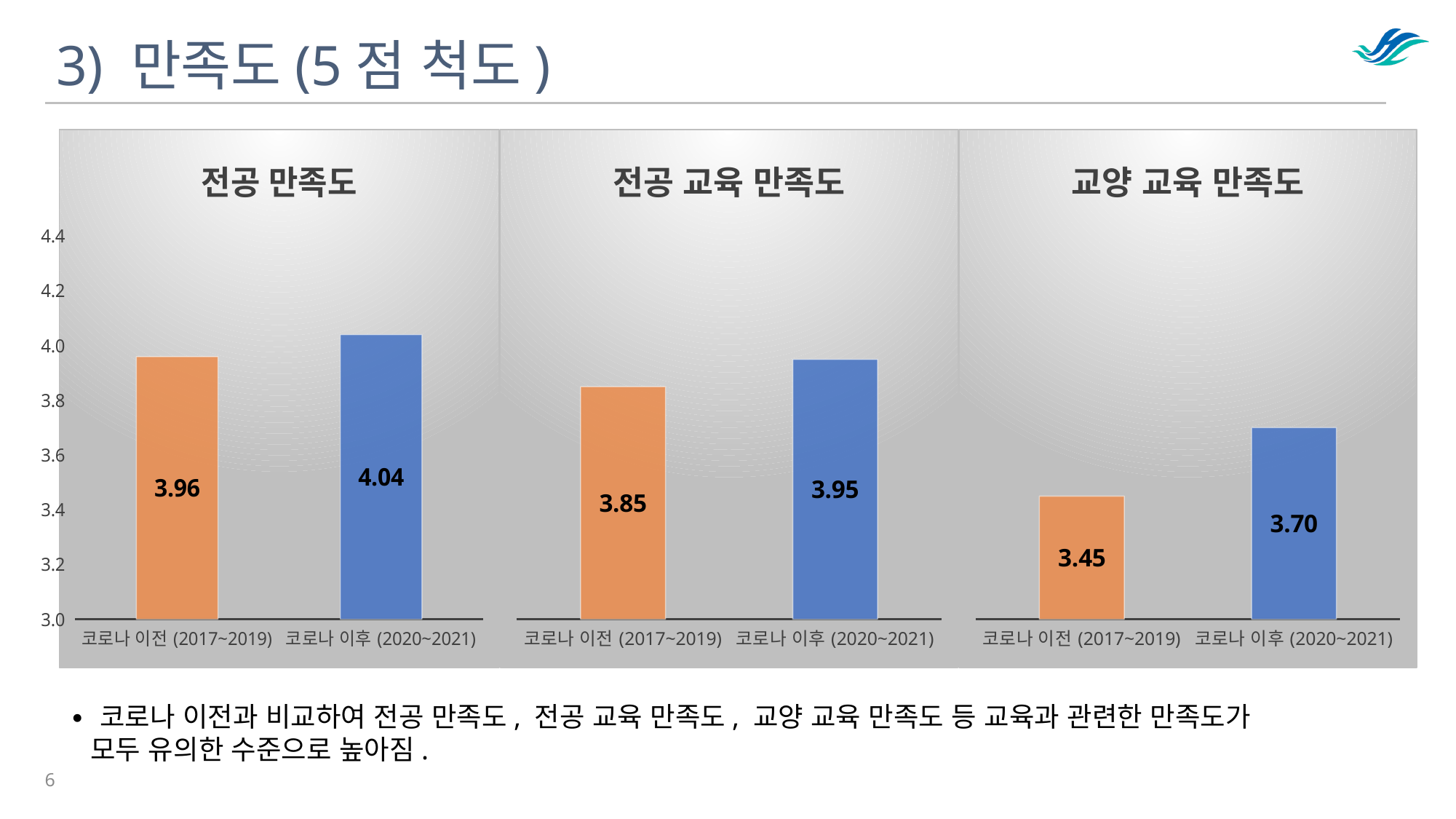
In the 전공 만족도 chart, is the value for 코로나 이후 (2020~2021) greater or less than 4.0? greater In the 전공 교육 만족도 chart, what is the difference between the 코로나 이후 (2020~2021) value and the 코로나 이전 (2017~2019) value? 0.10 In the 전공 만족도 chart, which is larger: the value for 코로나 이전 (2017~2019) or 코로나 이후 (2020~2021)? 코로나 이후 (2020~2021) In the 교양 교육 만족도 chart, which category has the lowest value? 코로나 이전 (2017~2019) In the 전공 교육 만족도 chart, which category has the highest value? 코로나 이후 (2020~2021) In the 교양 교육 만족도 chart, what is the difference between the 코로나 이후 (2020~2021) value and the 코로나 이전 (2017~2019) value? 0.25 How many bars are shown in the 교양 교육 만족도 chart? 2 What kind of chart is the 전공 교육 만족도 chart? bar chart In the 교양 교육 만족도 chart, what is the value for 코로나 이후 (2020~2021)? 3.70 In the 전공 교육 만족도 chart, what is the value for 코로나 이전 (2017~2019)? 3.85 In the 전공 만족도 chart, what is the value for 코로나 이후 (2020~2021)? 4.04 In the 전공 만족도 chart, what is the value for 코로나 이전 (2017~2019)? 3.96